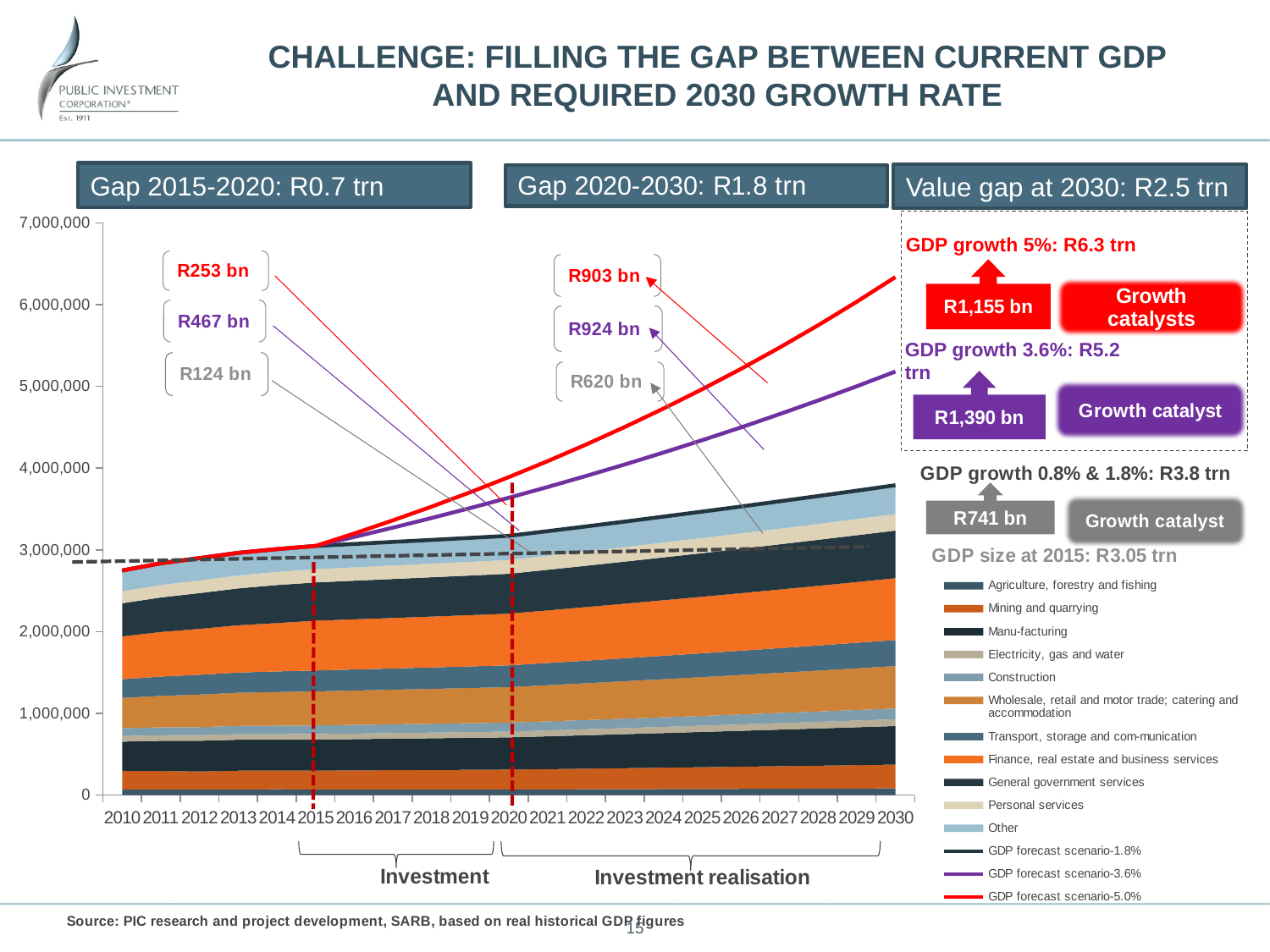
What kind of chart is shown on the slide? Stacked area chart with line overlays Is the value of the GDP forecast scenario-5.0% line at 2030 greater or less than 6,000,000? greater How many years are shown along the x axis of the chart? 21 Does the GDP forecast scenario-5.0% line rise or fall from 2015 to 2030? Rises What is the highest value shown on the y axis of the chart? 7,000,000 What is the difference between the Gap 2020-2030 and the Gap 2015-2020 shown in the header boxes? R1.1 trn What GDP value is given for the 5% growth scenario at 2030? R6.3 trn What is the GDP size at 2015 according to the chart annotation? R3.05 trn What GDP value is given for the 3.6% growth scenario at 2030? R5.2 trn How many entries does the chart legend list? 14 Is the value of the GDP forecast scenario-1.8% line at 2030 greater or less than 4,000,000? less Which GDP forecast scenario line is highest at 2030? GDP forecast scenario-5.0%